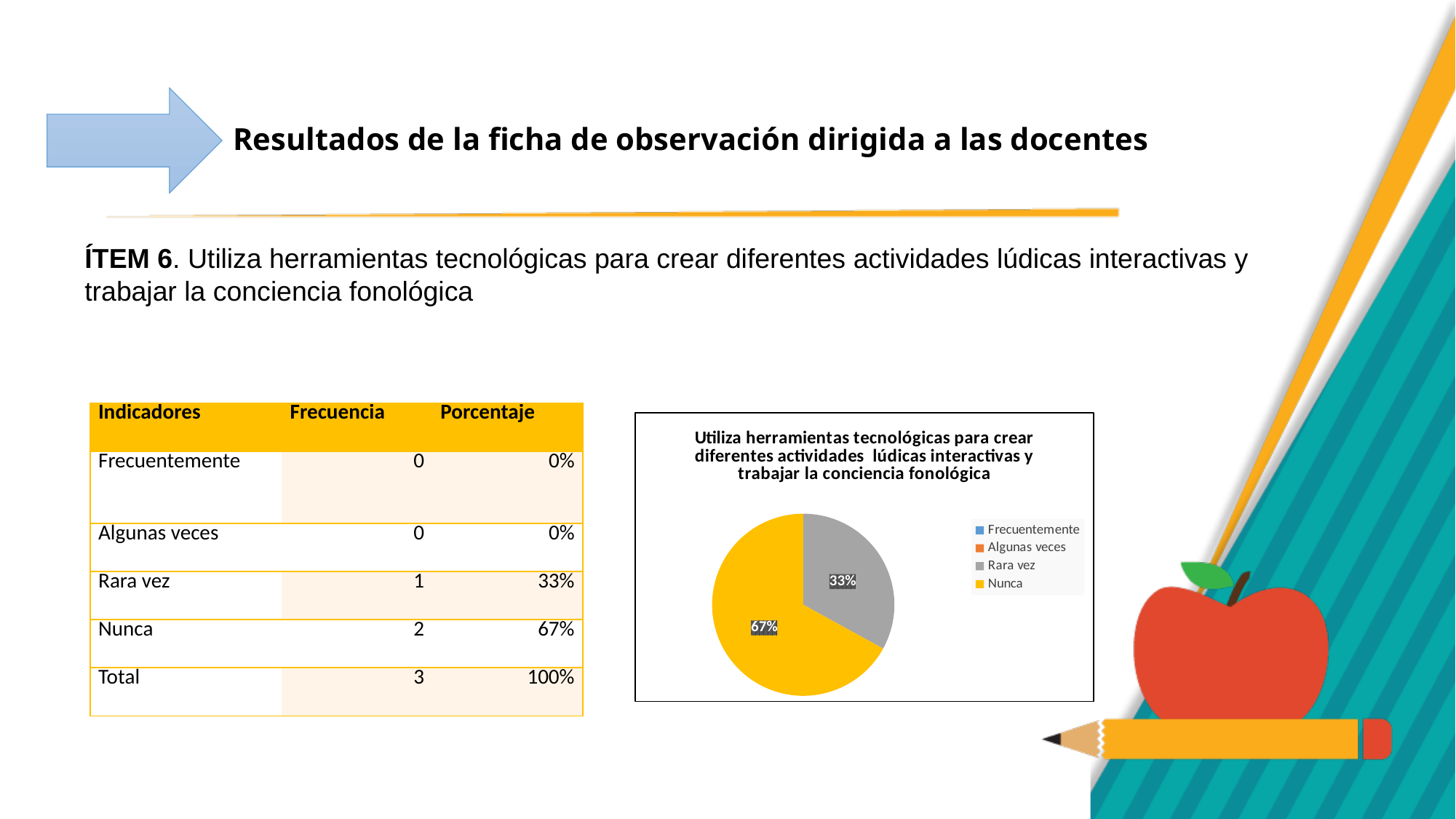
Which is larger in the pie chart, the Nunca slice or the Rara vez slice? Nunca What percentage does the Rara vez slice show in the pie chart? 33% Which category has the largest slice in the pie chart? Nunca Is the value for Nunca in the pie chart greater or less than 50%? greater What colour is the Rara vez slice in the pie chart? grey What is the difference in percentage points between the Nunca slice and the Rara vez slice? 34 What kind of chart is shown on the slide? pie chart What colour is the Nunca slice in the pie chart? yellow What percentage does the Nunca slice show in the pie chart? 67% How many slices are visible in the pie chart? 2 How many entries does the legend of the pie chart list? 4